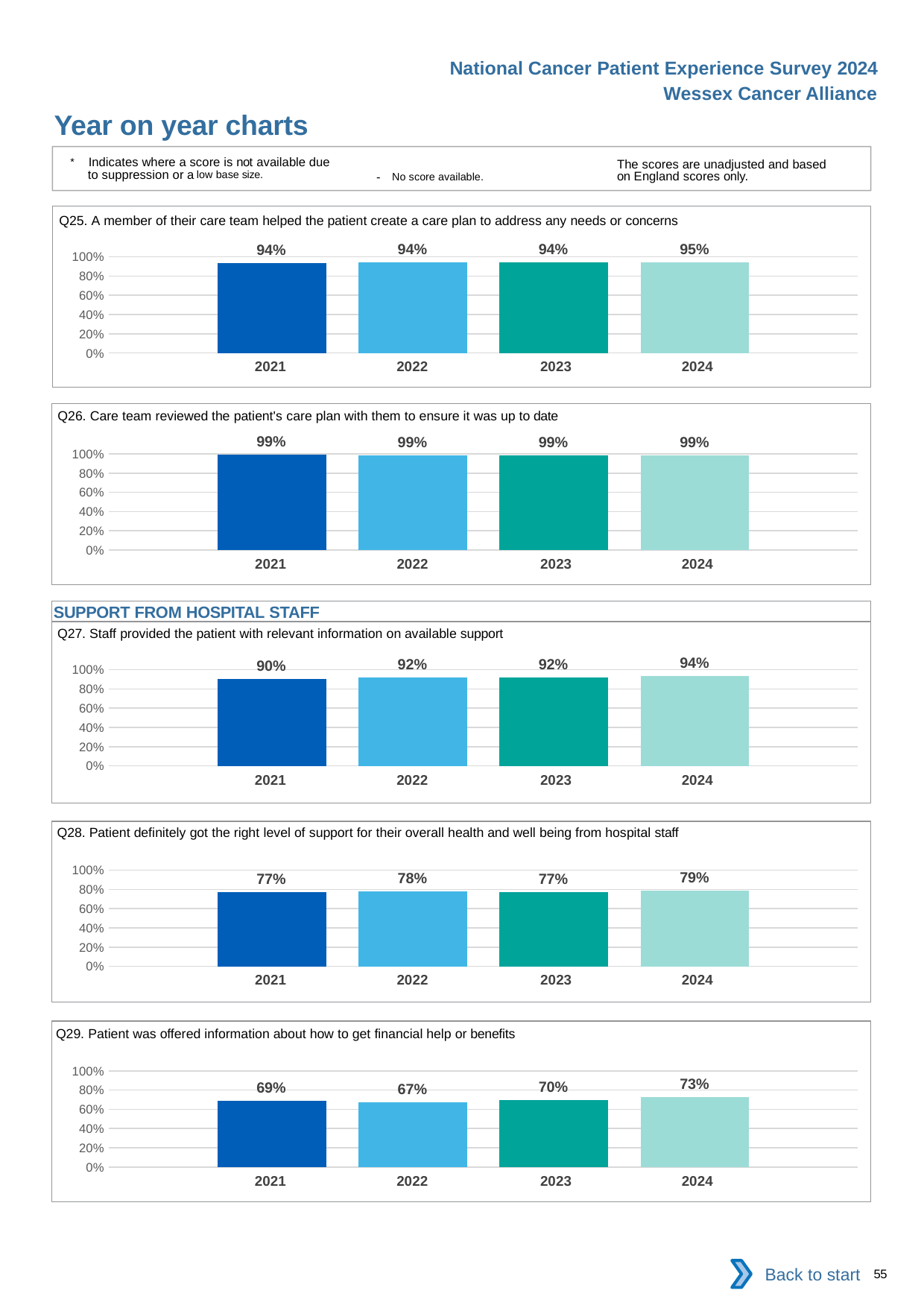
In the Q29 chart (information about financial help or benefits), is the value for 2021 greater or less than 80%? less What kind of chart is the Q28 chart? bar chart In the Q28 chart (right level of support from hospital staff), which year has the highest value? 2024 In the Q26 chart (care team reviewed the care plan), what is the value for 2021? 99% In the Q29 chart (information about financial help or benefits), which is larger, the value for 2023 or the value for 2024? 2024 In the Q27 chart (staff provided relevant information on available support), what is the difference between the 2024 and 2021 values? 4% In the Q29 chart (information about financial help or benefits), which year has the lowest value? 2022 In the Q29 chart (information about financial help or benefits), what is the difference between the 2024 and 2022 values? 6% In the Q25 chart (care team helped create a care plan), what is the value for 2024? 95% In the Q27 chart (staff provided relevant information on available support), which year has the lowest value? 2021 In the Q28 chart (right level of support from hospital staff), what is the value for 2022? 78% How many years are shown on the x axis of the Q25 chart? 4